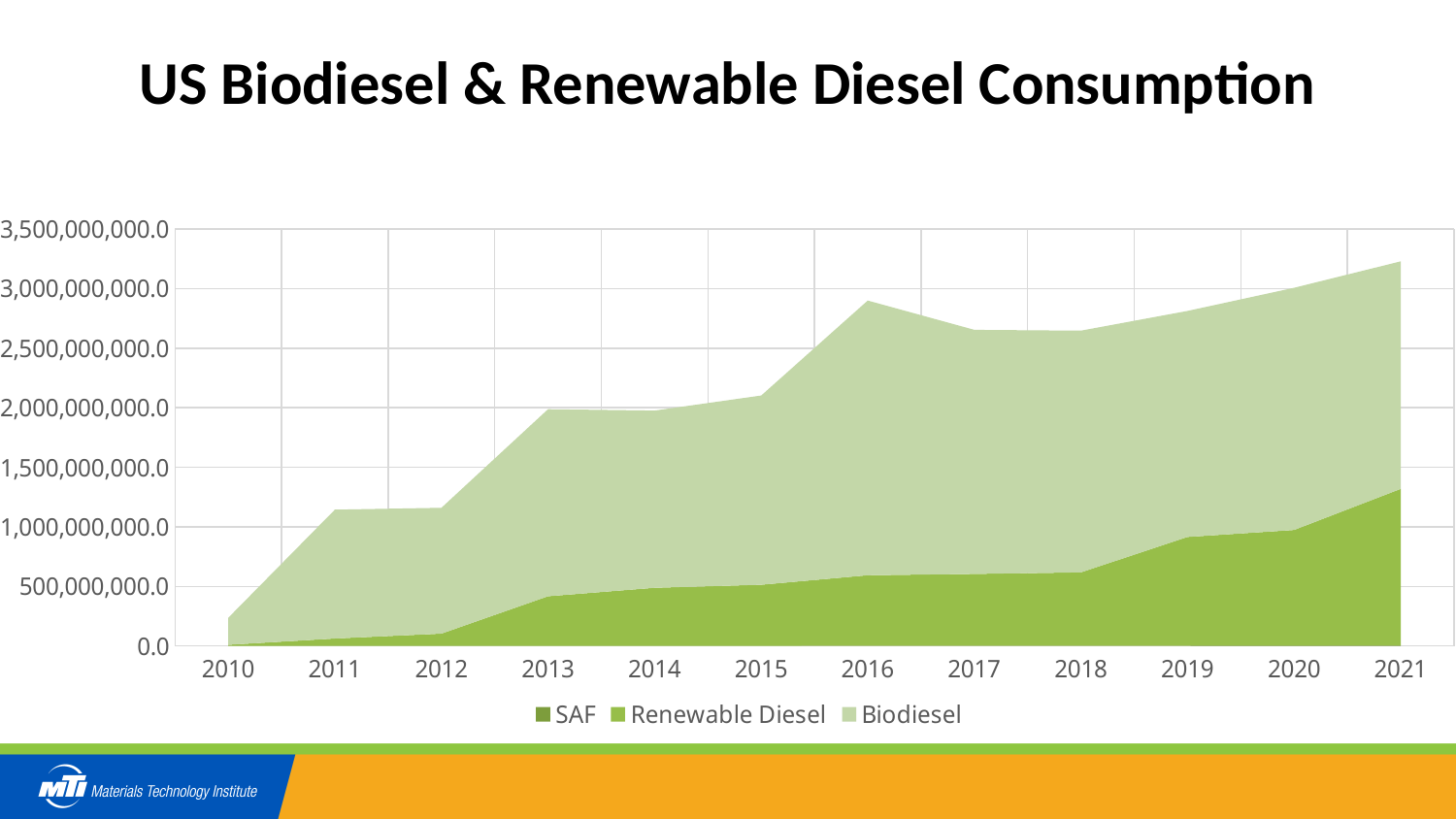
Is the total consumption in 2016 greater or less than 2,500,000,000.0? greater What is the title of the chart? US Biodiesel & Renewable Diesel Consumption How many series does the legend list? 3 In which year is total consumption highest? 2021 Which series are listed in the legend? SAF, Renewable Diesel, Biodiesel In which year is total consumption lowest? 2010 Is the total consumption in 2021 greater or less than 3,000,000,000.0? greater What kind of chart is shown on the slide? Stacked area chart Does total consumption generally rise or fall from 2010 to 2021? Rise Is the total consumption in 2010 greater or less than 500,000,000.0? less How many years are shown along the x axis? 12 Is the total consumption in 2016 larger or smaller than in 2017? larger